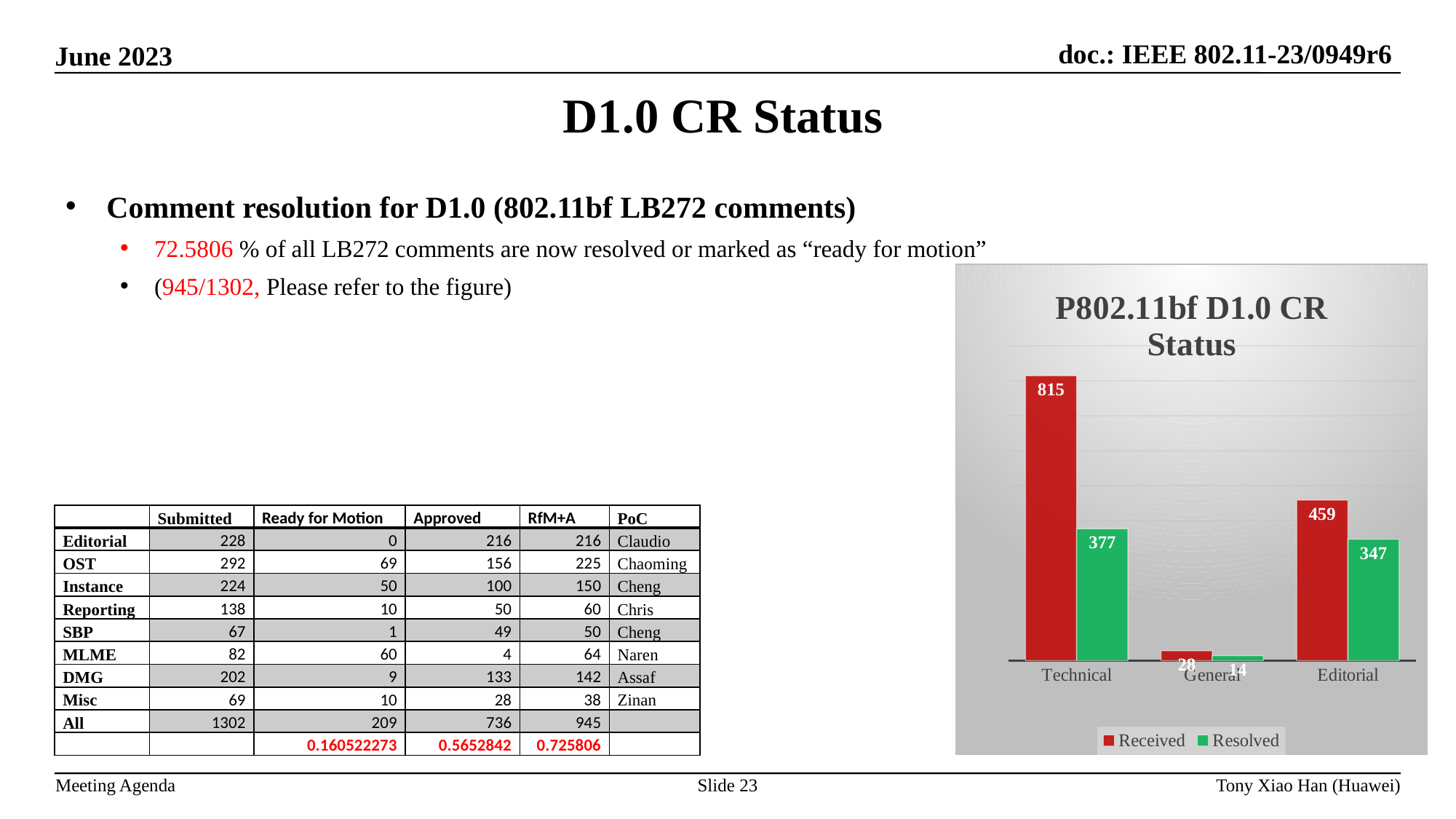
Which category has the lowest Resolved value in the P802.11bf D1.0 CR Status chart? General Which colour represents the Resolved series in the P802.11bf D1.0 CR Status chart? Green What is the difference between the Received values for Technical and Editorial in the P802.11bf D1.0 CR Status chart? 356 Is the Resolved value for Technical or the Resolved value for Editorial larger in the P802.11bf D1.0 CR Status chart? Technical What is the Received value for Technical in the P802.11bf D1.0 CR Status chart? 815 What type of chart is the P802.11bf D1.0 CR Status chart? Bar chart How many categories are shown on the x axis of the P802.11bf D1.0 CR Status chart? 3 How many series does the legend of the P802.11bf D1.0 CR Status chart list? 2 Which category has the highest Received value in the P802.11bf D1.0 CR Status chart? Technical What is the Resolved value for General in the P802.11bf D1.0 CR Status chart? 14 What is the difference between Received and Resolved for Technical in the P802.11bf D1.0 CR Status chart? 438 What is the Resolved value for Editorial in the P802.11bf D1.0 CR Status chart? 347